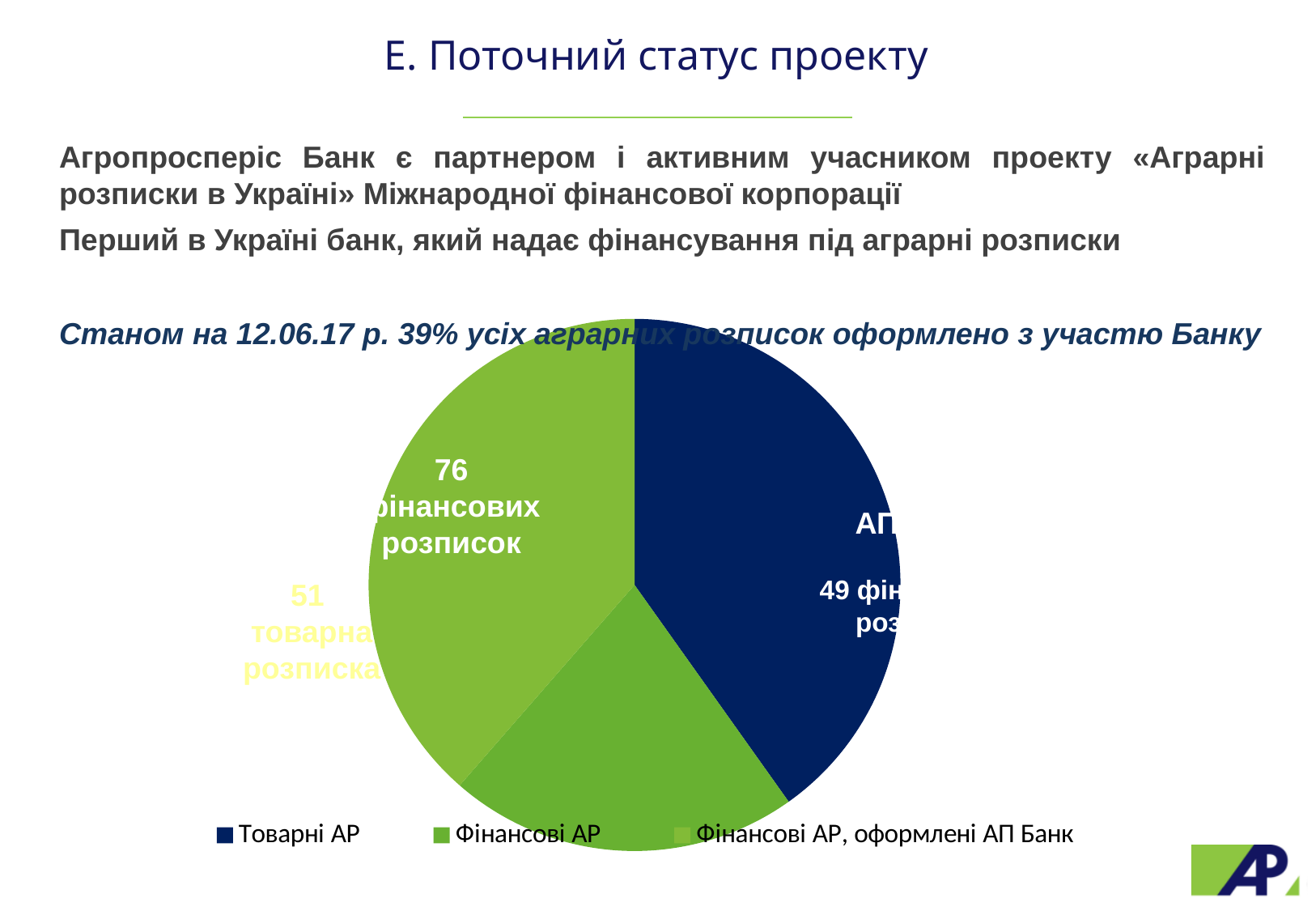
What is the first legend entry of the pie chart? Товарні АР Which is larger on the pie chart: the number of фінансових розписок (76) or the number of товарна розписка (51)? фінансових розписок What number is printed with the label 'товарна розписка' on the pie chart? 51 What is the last legend entry of the pie chart? Фінансові АР, оформлені АП Банк What number is printed with the label 'фінансових розписок' on the pie chart? 76 What is the difference between the 76 фінансових розписок and the 51 товарна розписка shown on the pie chart? 25 According to the text above the pie chart, what share of all agrarian receipts was issued with the Bank's participation as of 12.06.17? 39% What kind of chart is shown on the slide? pie chart How many entries does the legend of the pie chart list? 3 How many slices does the pie chart have? 3